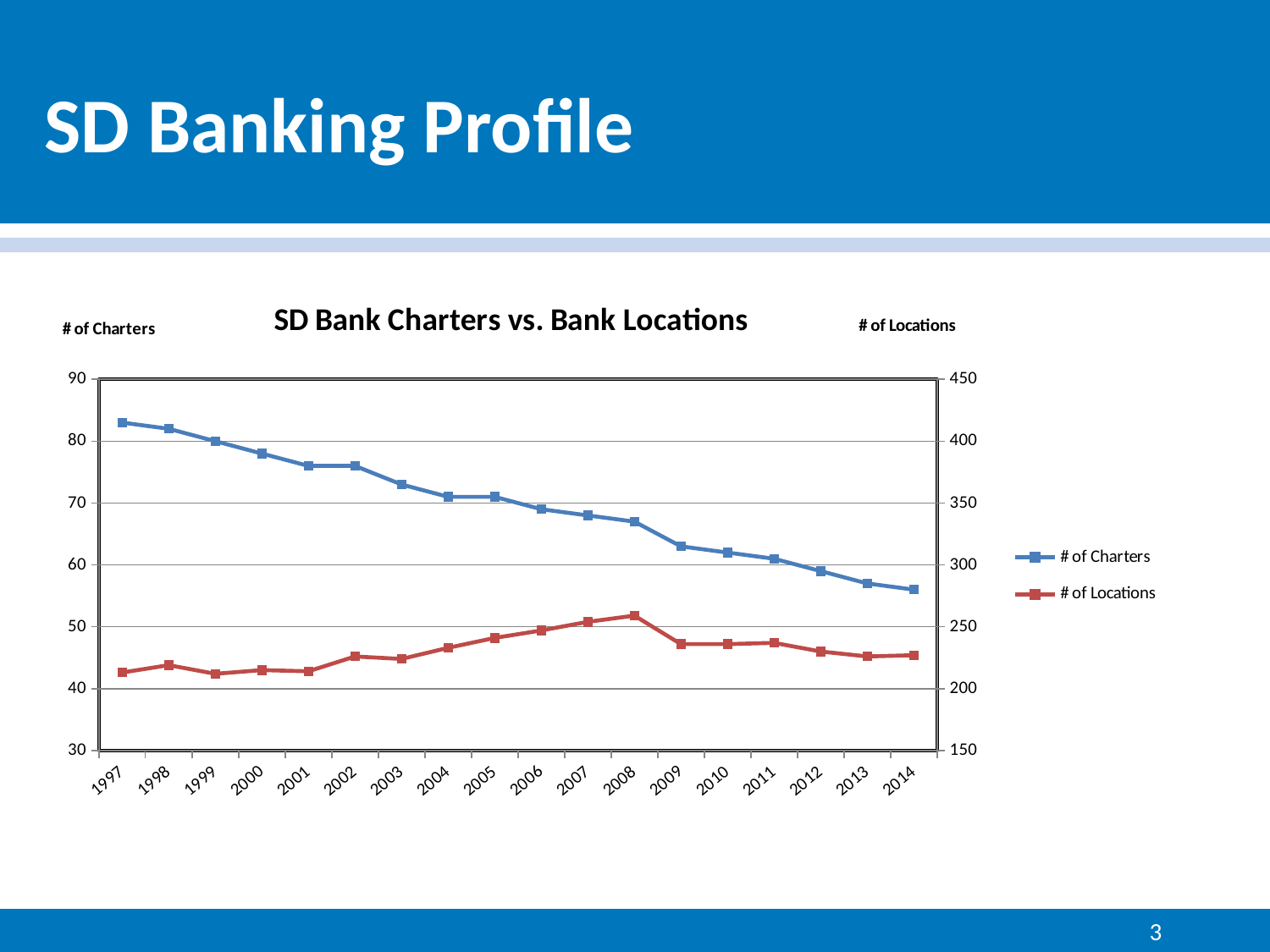
In which year is the # of Locations highest? 2008 How many series does the legend list? 2 Is the # of Charters in 2014 greater or less than 60? less How many years are plotted along the x axis? 18 In which year is the # of Charters lowest? 2014 Is the # of Charters in 1997 greater or less than 80? greater Which axis label appears on the right side of the chart? # of Locations Is the # of Locations in 2008 greater or less than 250? greater Does the # of Charters rise or fall from 1997 to 2014? fall In which year is the # of Charters highest? 1997 What is the title of the chart? SD Bank Charters vs. Bank Locations What kind of chart is shown on the slide? line chart